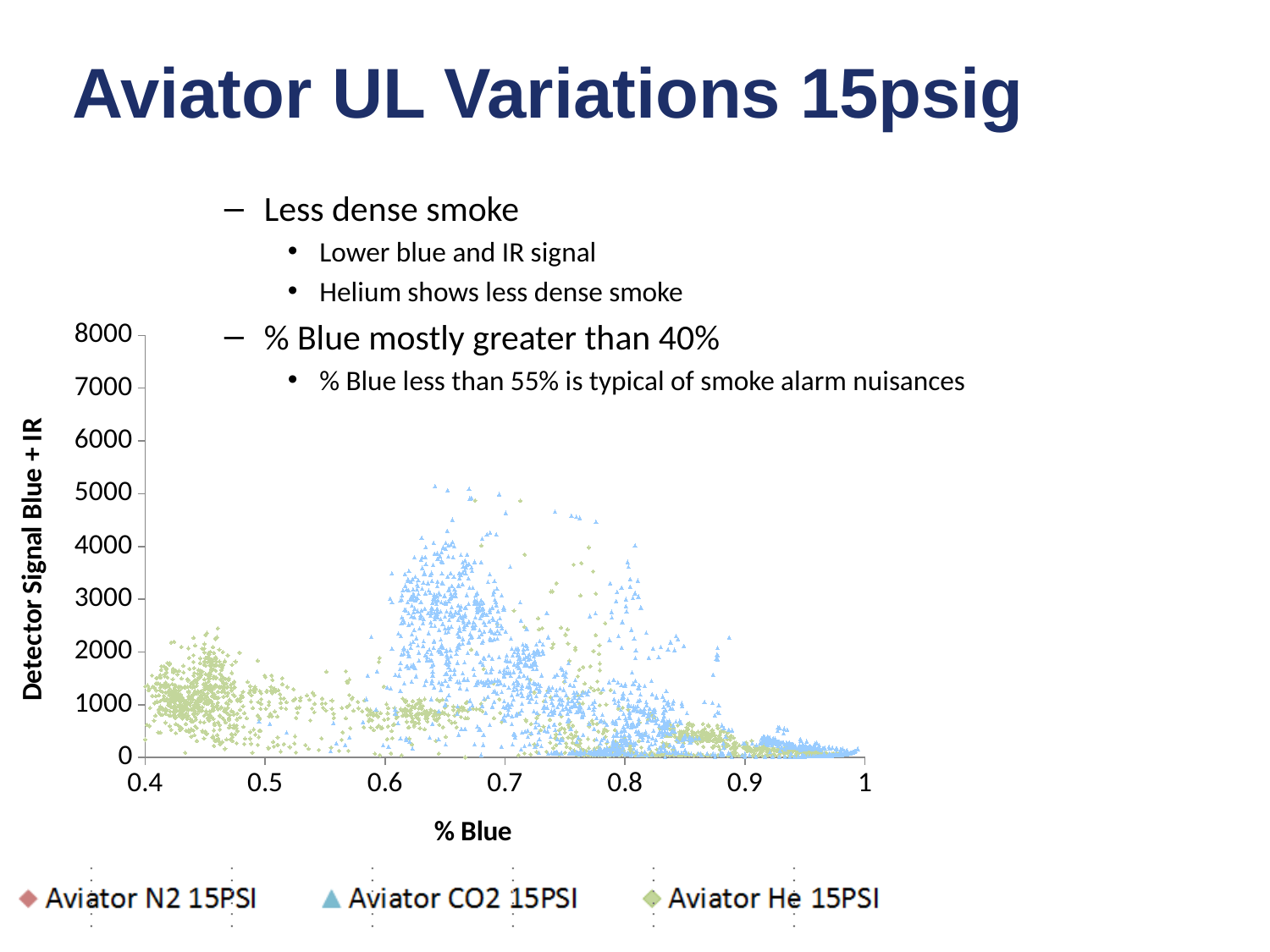
Which series has points plotted at % Blue values near 0.4? Aviator He 15PSI Is the highest point of the Aviator CO2 15PSI series greater or less than 6000? less What is the title of the x axis? % Blue Is the highest point of the Aviator He 15PSI series greater or less than 4000? greater Is the highest point of the Aviator CO2 15PSI series greater or less than 4000? greater What is the title of the y axis? Detector Signal Blue + IR How many series does the legend list? 3 What kind of chart is shown on the slide? Scatter chart